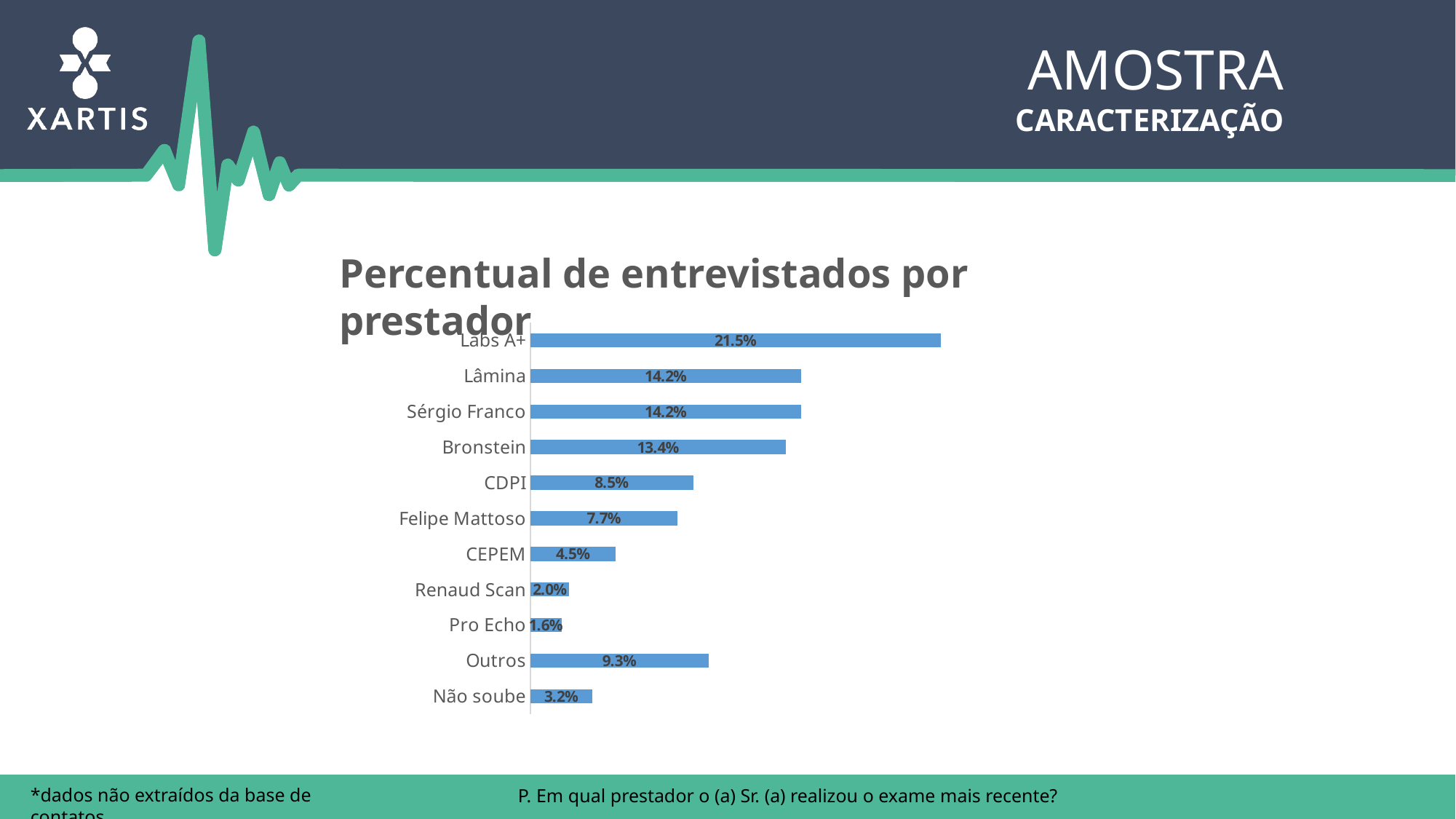
What is the difference between Outros and Felipe Mattoso? 1.6% What value is shown for Pro Echo? 1.6% What percentage is shown for CDPI? 8.5% What type of chart is shown on the slide? Bar chart Which is larger, the value for CEPEM or the value for Não soube? CEPEM What value is shown for Bronstein? 13.4% What percentage of respondents is shown for Labs A+? 21.5% What is the difference between Labs A+ and Lâmina? 7.3% Which category has the lowest percentage? Pro Echo Which provider has the highest percentage of respondents? Labs A+ How many categories (bars) does the chart show? 11 What is the title of the chart? Percentual de entrevistados por prestador